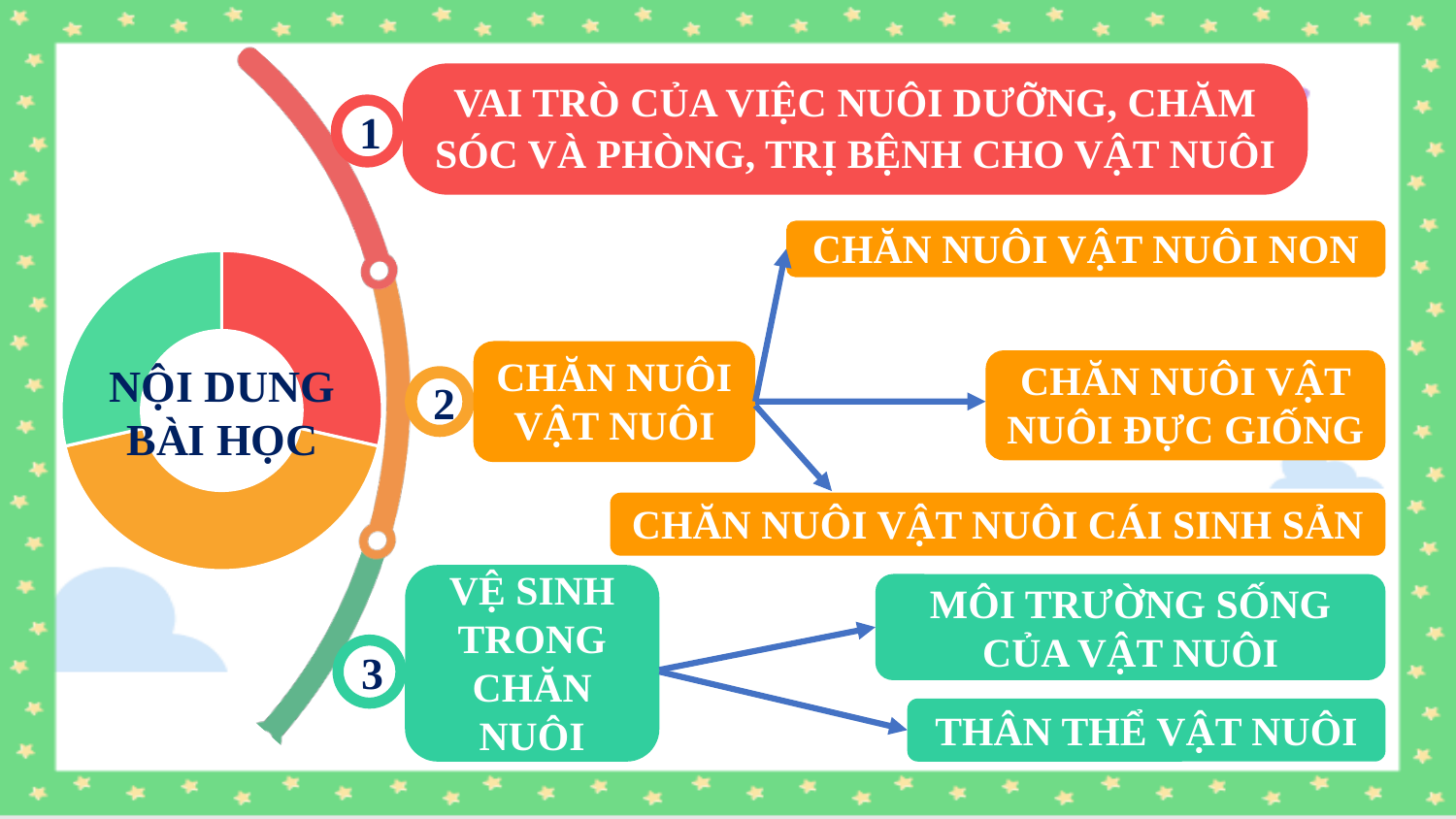
What text appears in the centre of the donut chart? NỘI DUNG BÀI HỌC How many segments does the donut chart on the left have? 3 What kind of chart is shown on the left of the slide? Pie (donut) chart Does the donut chart display any numeric data labels? No Which colour segment of the donut chart is the largest? Orange